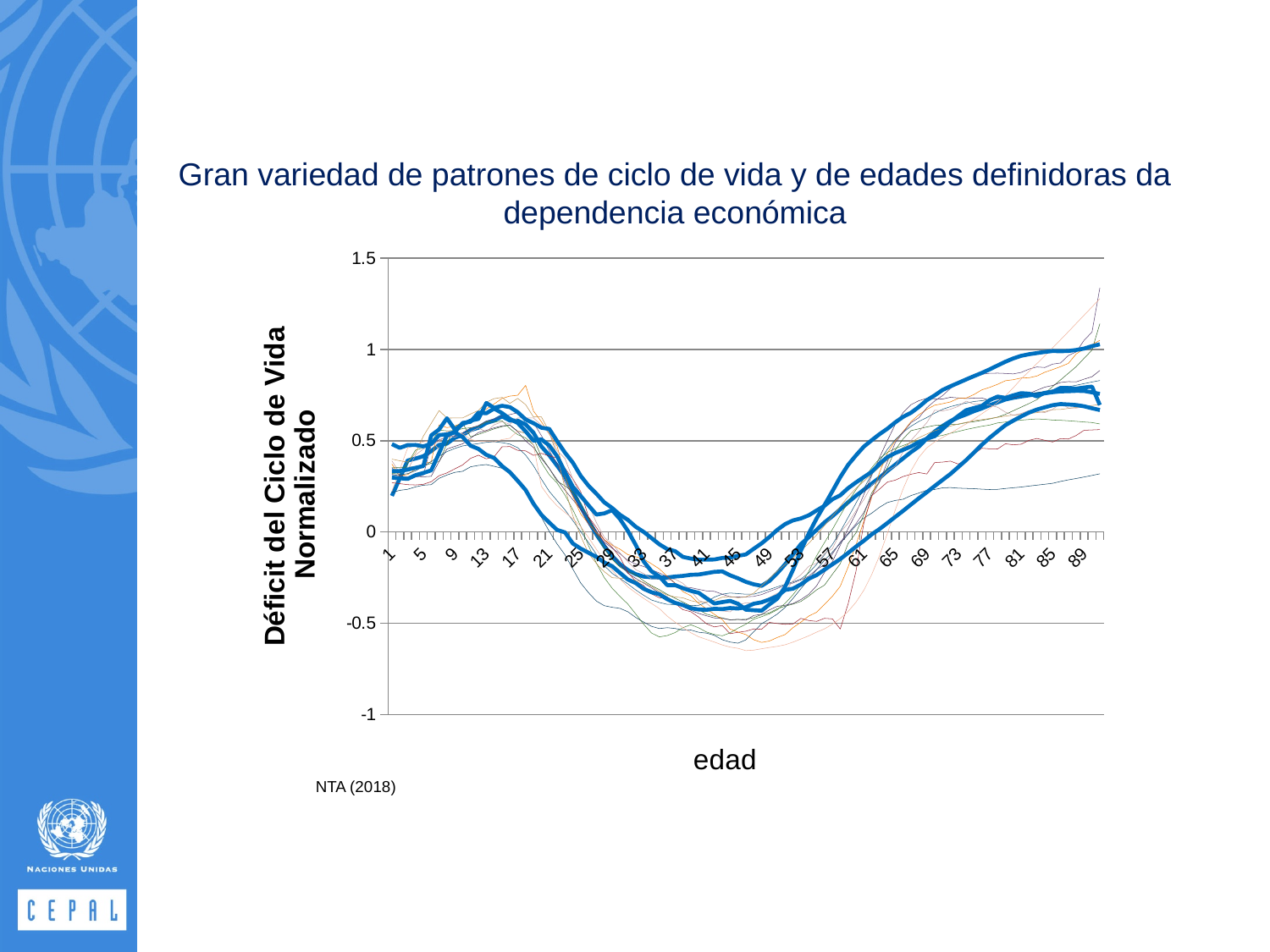
What is the title of the y axis of the chart? Déficit del Ciclo de Vida Normalizado At age 85, are the plotted values greater or less than 0? greater At age 13, are the plotted values greater or less than 1? less At age 41, are the plotted values greater or less than 0? less What is the first age label shown on the x axis? 1 What is the title of the x axis of the chart? edad What is the last age label shown on the x axis? 89 What kind of chart is shown on the slide? line chart Between ages 17 and 45, do the lines generally rise or fall? fall What is the lowest value shown on the y axis? -1 Between ages 45 and 85, do the lines generally rise or fall? rise